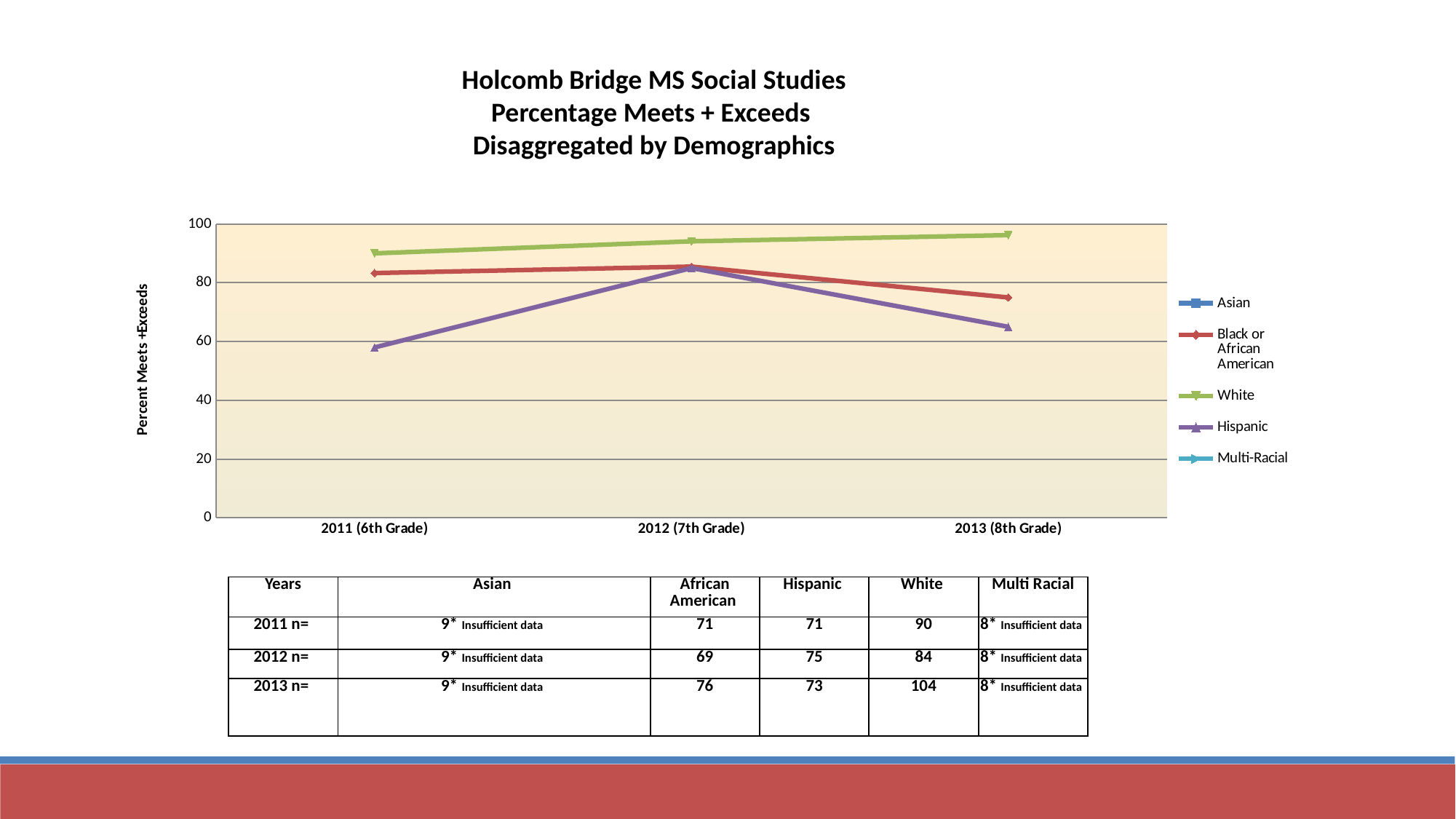
How many points are there along the x axis of the chart? 3 Which series has the highest value in 2013 (8th Grade)? White Is the value for Hispanic in 2011 (6th Grade) greater or less than 40? greater Does the White series rise or fall from 2011 (6th Grade) to 2013 (8th Grade)? rise Which is larger in 2013 (8th Grade): the value for Black or African American or the value for Hispanic? Black or African American Is the value for Black or African American in 2013 (8th Grade) greater or less than 80? less Which plotted series has the lowest value in 2011 (6th Grade)? Hispanic Which is larger in 2011 (6th Grade): the value for White or the value for Hispanic? White What kind of chart is shown on the slide? line chart Is the value for White in 2011 (6th Grade) greater or less than 80? greater How many series does the chart's legend list? 5 What is the label of the chart's vertical axis? Percent Meets +Exceeds